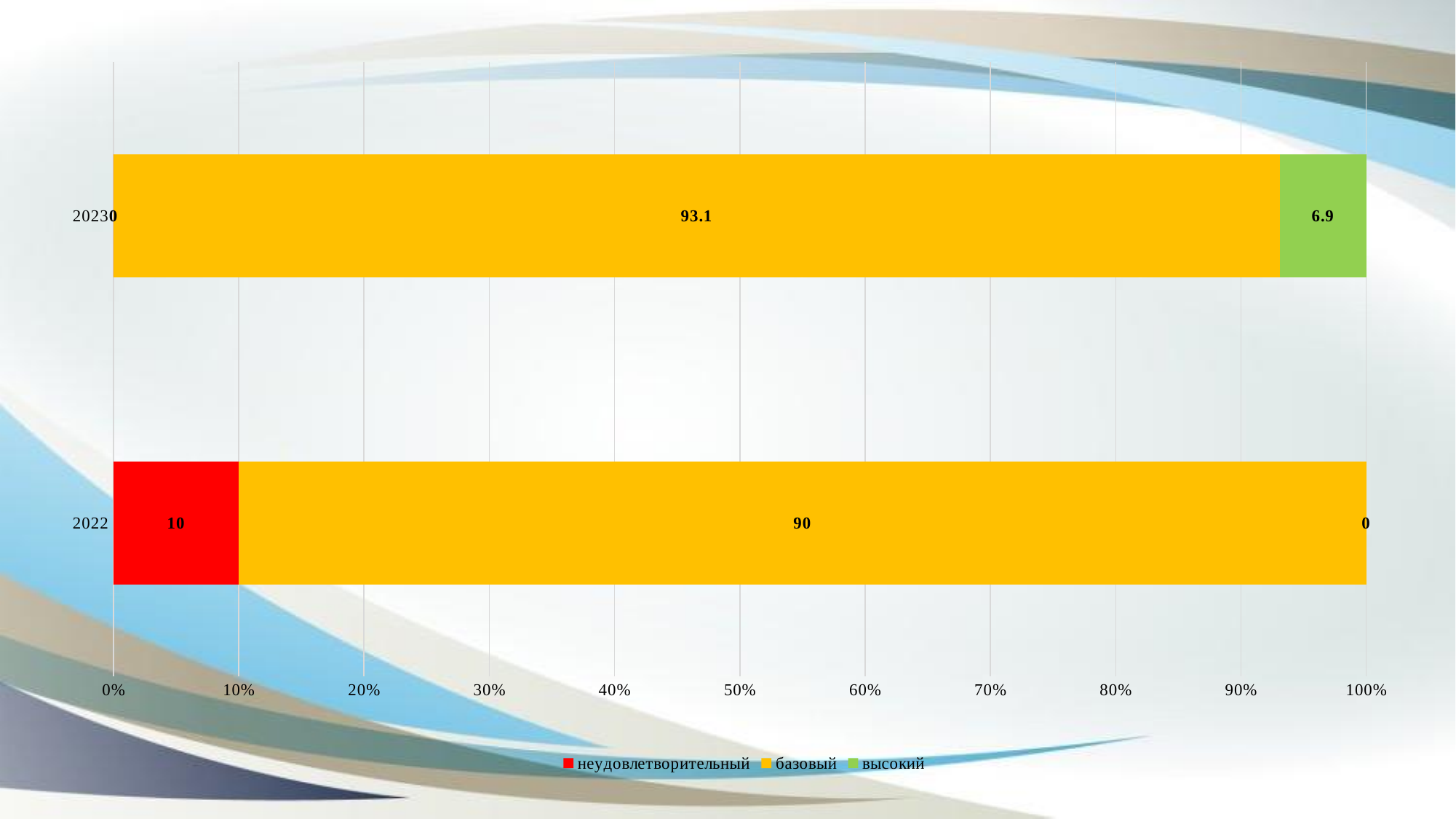
Which colour represents the высокий series in the legend? Green What is the value of the высокий series for 2022? 0 Which year has the higher value for the базовый series? 2023 How many categories (years) are shown on the chart? 2 What is the value of the высокий series for 2023? 6.9 What is the value of the неудовлетворительный series for 2023? 0 What kind of chart is shown on the slide? Stacked bar chart What is the value of the базовый series for 2022? 90 What is the value of the базовый series for 2023? 93.1 What is the value of the неудовлетворительный series for 2022? 10 How many series does the legend list? 3 What is the difference between the базовый values for 2023 and 2022? 3.1